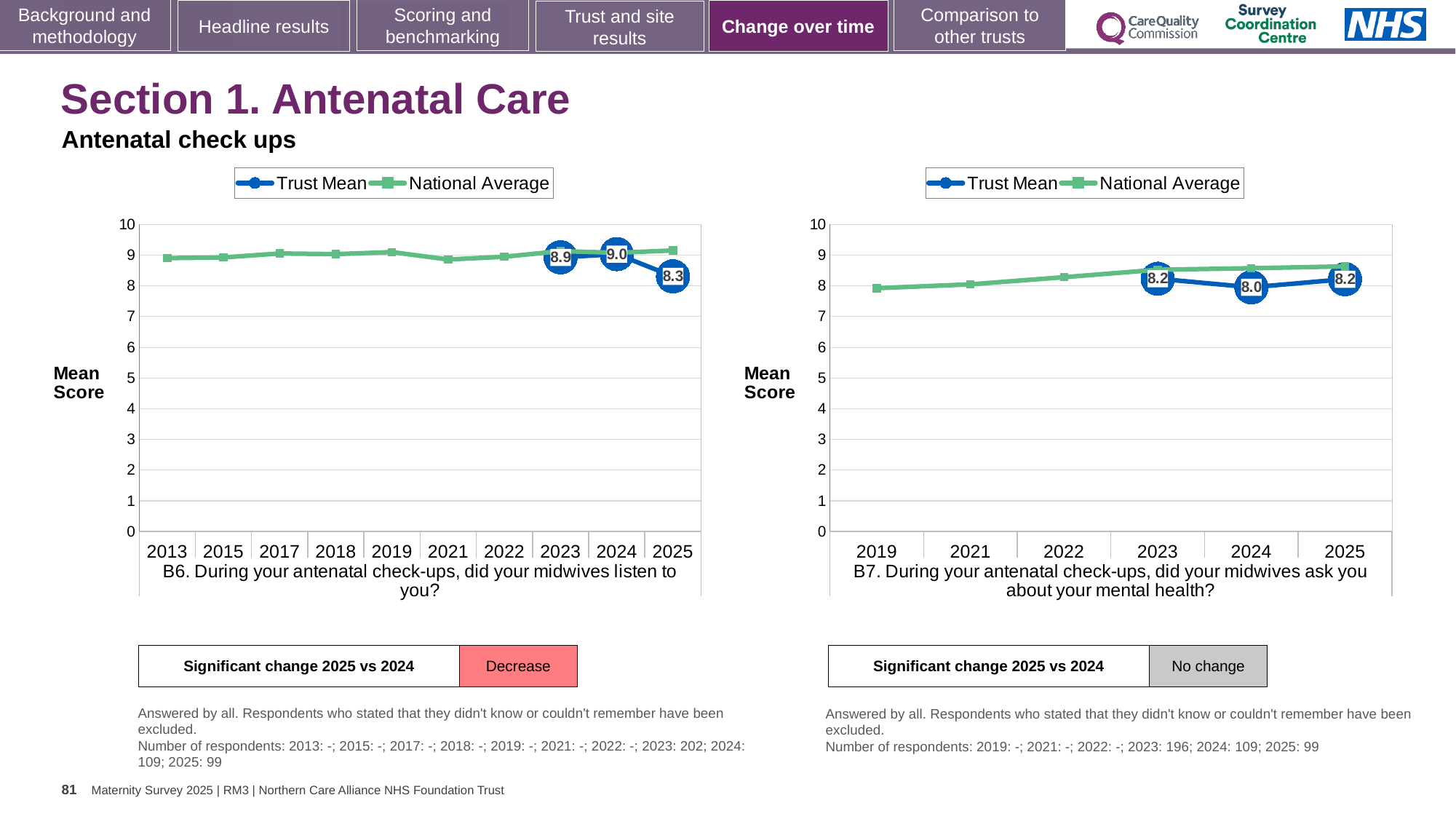
In the B6 chart (left), does the Trust Mean rise or fall from 2024 to 2025? Fall How many series does the legend of the B6 chart (left) list? 2 What kind of chart is the B6 chart (left)? Line chart In the B6 chart (left), what is the Trust Mean for 2024? 9.0 In the B7 chart (right), what is the difference between the Trust Mean in 2023 and 2024? 0.2 In the B7 chart (right), is the Trust Mean for 2024 greater or less than 9? less In the B7 chart (right), what is the Trust Mean for 2024? 8.0 In the B6 chart (left), what is the Trust Mean for 2025? 8.3 In the B6 chart (left), by how much did the Trust Mean fall from 2024 to 2025? 0.7 In the B6 chart (left), which year has the lowest labelled Trust Mean? 2025 How many years are shown on the x axis of the B7 chart (right)? 6 In the B7 chart (right), what is the Trust Mean for 2023? 8.2